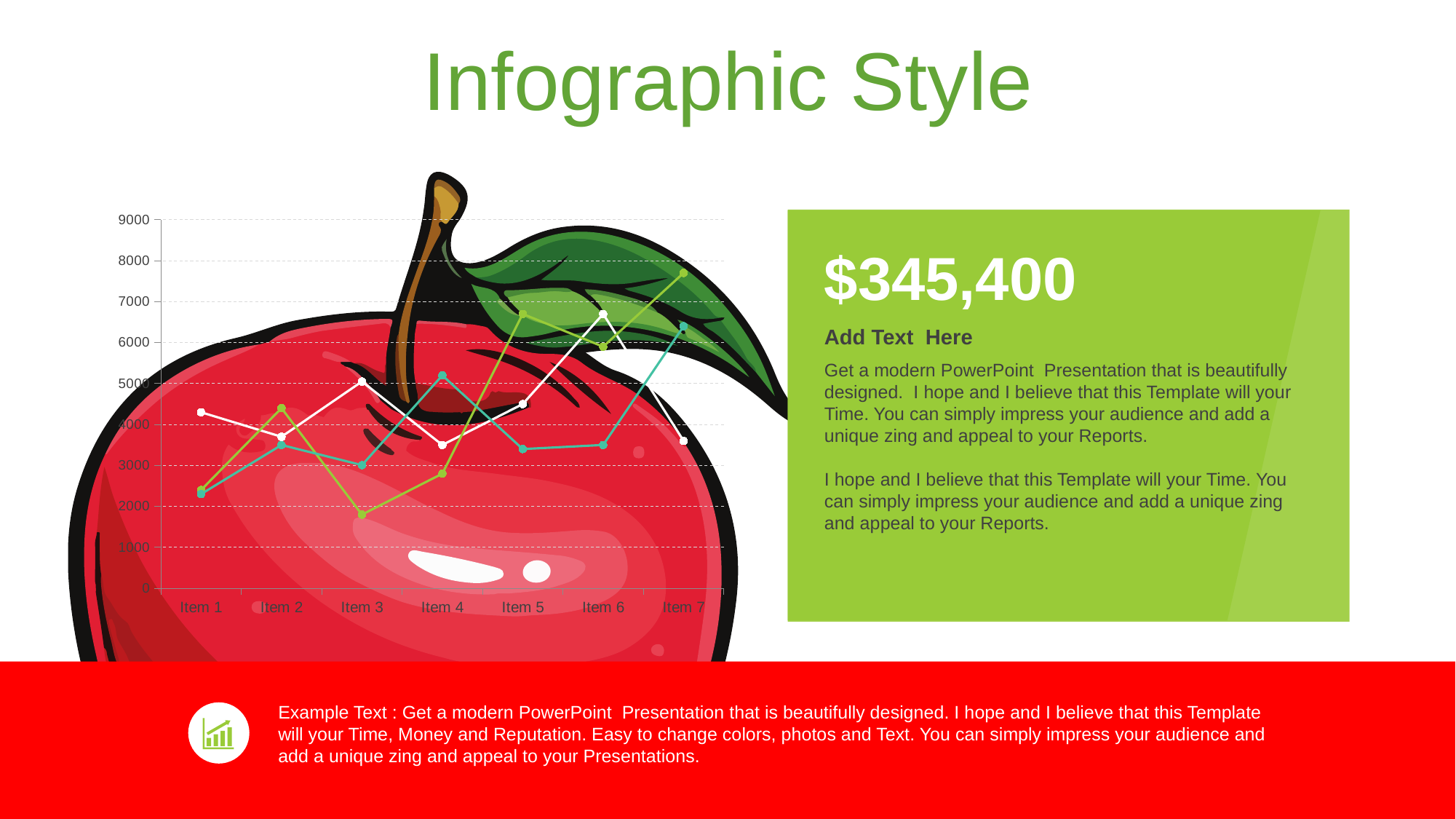
For which category does the green line reach its lowest value? Item 3 How many lines are plotted on the chart? 3 Is the value of the teal line for Item 1 greater or less than 3000? less Is the value of the white line for Item 6 greater or less than 6000? greater How many categories are shown on the x axis of the chart? 7 What kind of chart is shown on the slide? line chart Is the value of the green line for Item 7 greater or less than 7000? greater What is the highest value shown on the chart's y axis? 9000 For Item 4, which line has the larger value, the teal line or the green line? teal line What is the label of the first category on the x axis? Item 1 For which category does the green line reach its highest value? Item 7